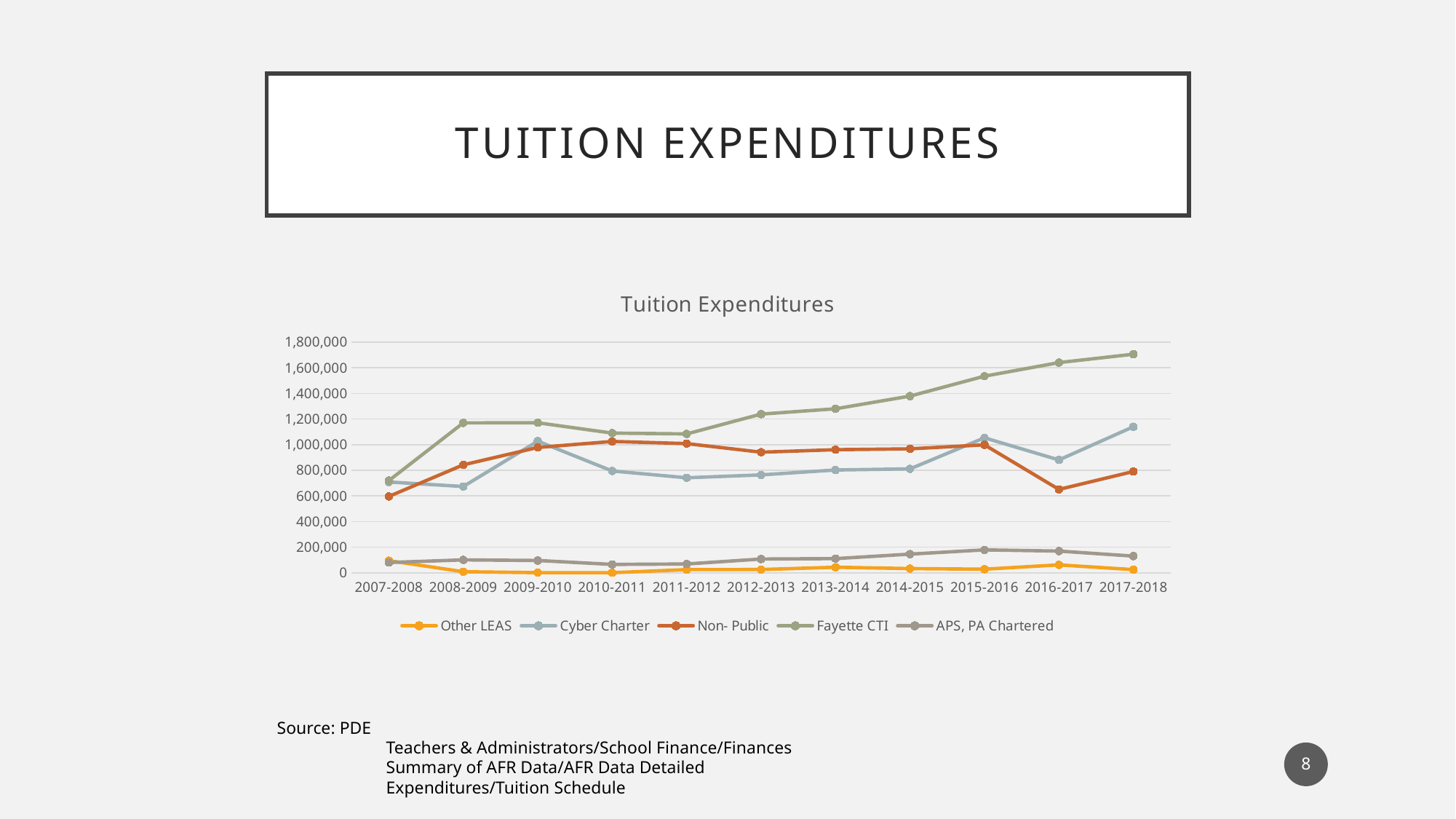
Is the value for Fayette CTI in 2017-2018 greater or less than 1,600,000? greater How many school years are shown along the x axis of the Tuition Expenditures chart? 11 Which series has the lowest value in 2010-2011? Other LEAS Is the value for Non- Public in 2007-2008 greater or less than 800,000? less Which series has the highest value in 2017-2018? Fayette CTI Is the value for APS, PA Chartered in 2015-2016 greater or less than 400,000? less What kind of chart is shown on the slide? Line chart Does the Fayette CTI line rise or fall from 2011-2012 to 2017-2018? Rises How many series does the legend of the Tuition Expenditures chart list? 5 What is the title of the chart? Tuition Expenditures In 2016-2017, which is larger: Cyber Charter or Non- Public? Cyber Charter